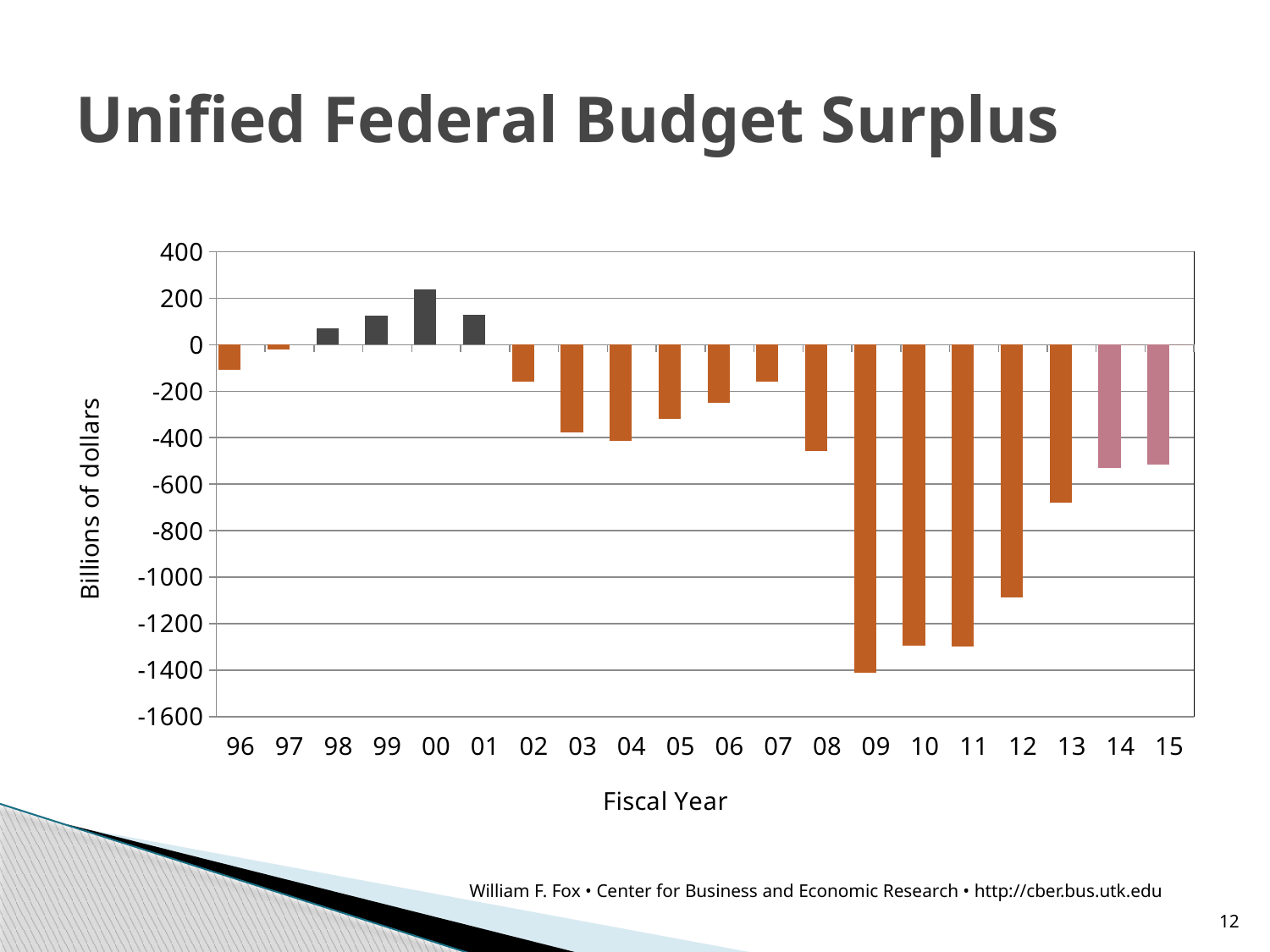
What is the label on the vertical axis of the chart? Billions of dollars Which fiscal year has the lowest value on the chart? 09 Is the value for fiscal year 08 greater or less than -400? less Do the values rise or fall from fiscal year 09 to fiscal year 13? rise Which fiscal year has the highest value on the chart? 00 Which fiscal year has the larger value, 08 or 13? 08 Is the value for fiscal year 12 greater or less than -1000? less Is the value for fiscal year 13 greater or less than -800? greater How many fiscal years are plotted on the chart? 20 What kind of chart is shown on the slide? bar chart